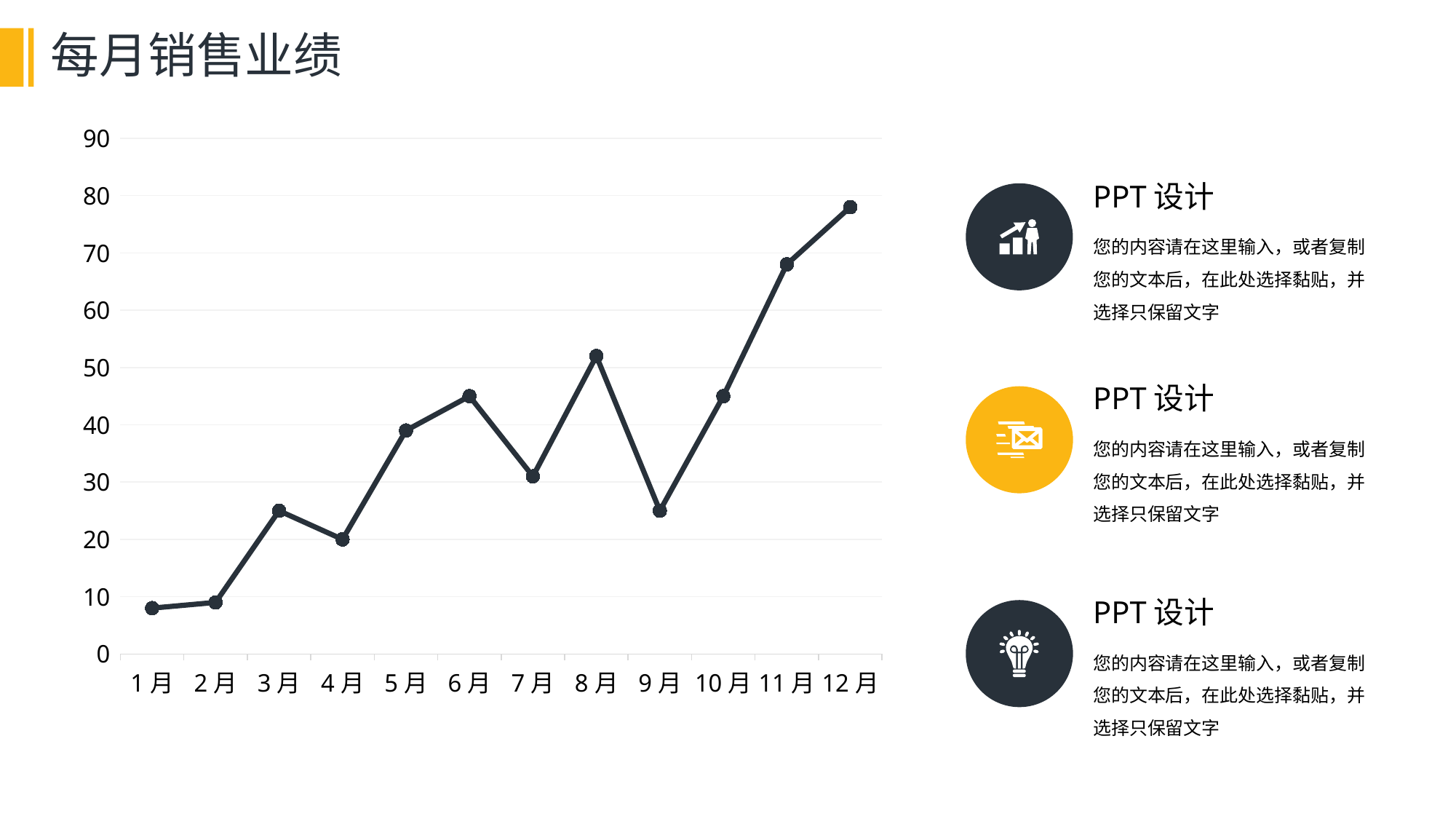
Which is larger, the value for 8 月 or the value for 6 月? 8 月 What is the title of the chart? 每月销售业绩 Which month has the highest value? 12 月 How many months are plotted on the x axis? 12 Which is larger, the value for 3 月 or the value for 4 月? 3 月 Overall, do the values rise or fall from 1 月 to 12 月? rise What kind of chart is shown on the slide? line chart Is the value for 8 月 greater or less than 50? greater Is the value for 1 月 greater or less than 10? less Is the value for 9 月 greater or less than 30? less